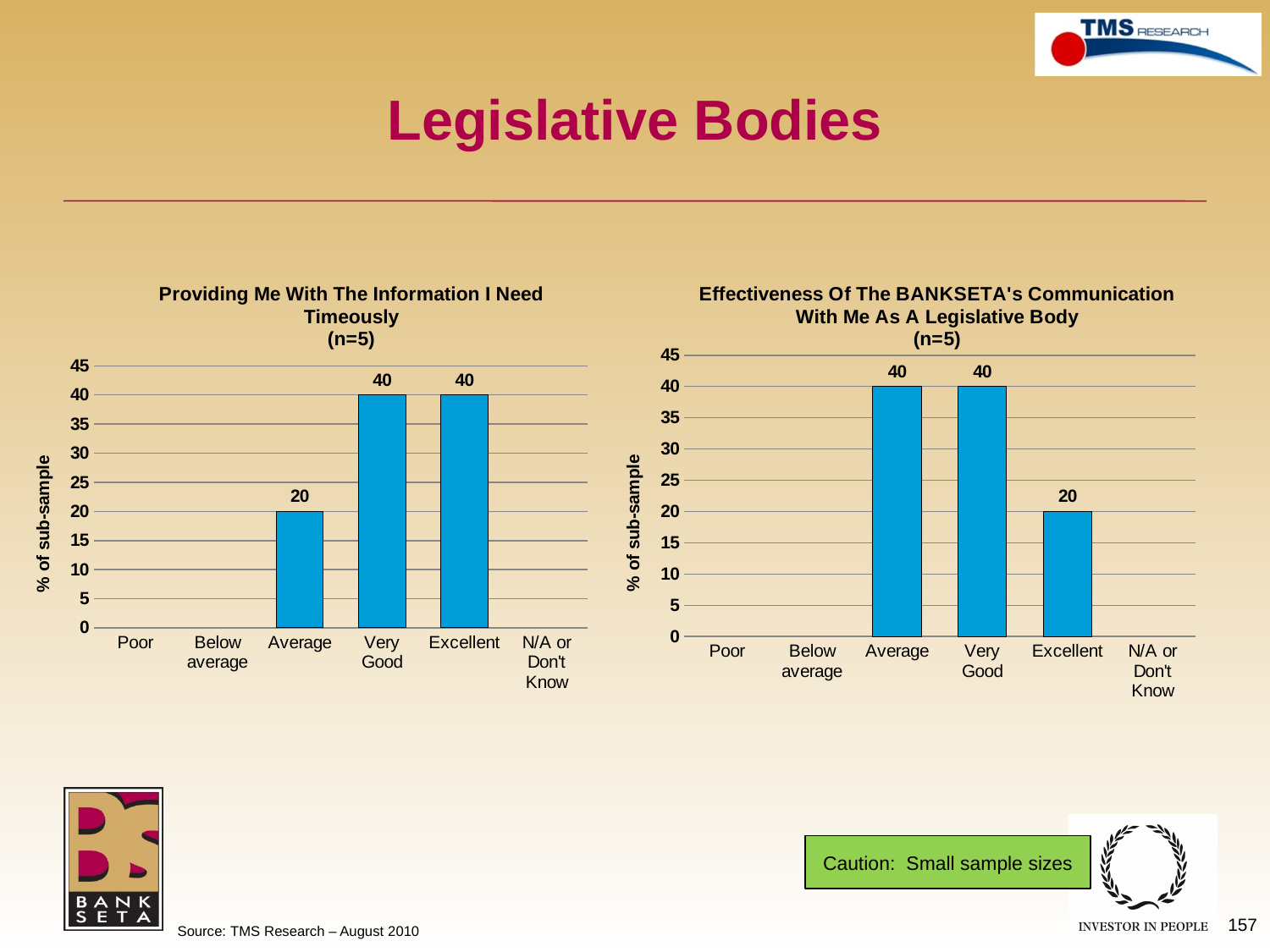
In the 'Effectiveness Of The BANKSETA's Communication With Me As A Legislative Body' chart, what is the value for Average? 40 In the 'Providing Me With The Information I Need Timeously' chart, what is the value for Very Good? 40 In the 'Effectiveness Of The BANKSETA's Communication With Me As A Legislative Body' chart, which category has the lowest non-zero value? Excellent In the 'Effectiveness Of The BANKSETA's Communication With Me As A Legislative Body' chart, what is the value for Excellent? 20 What sample size (n) is stated in the title of the 'Effectiveness Of The BANKSETA's Communication With Me As A Legislative Body' chart? n=5 What is the y-axis label of the 'Providing Me With The Information I Need Timeously' chart? % of sub-sample How many categories are shown on the x axis of the 'Providing Me With The Information I Need Timeously' chart? 6 In the 'Providing Me With The Information I Need Timeously' chart, which is larger, the value for Average or the value for Excellent? Excellent What kind of chart is the 'Effectiveness Of The BANKSETA's Communication With Me As A Legislative Body' chart? Bar chart In the 'Providing Me With The Information I Need Timeously' chart, what is the value for Average? 20 In the 'Effectiveness Of The BANKSETA's Communication With Me As A Legislative Body' chart, which is larger, the value for Very Good or the value for Excellent? Very Good In the 'Providing Me With The Information I Need Timeously' chart, what is the difference between the Very Good and Average values? 20